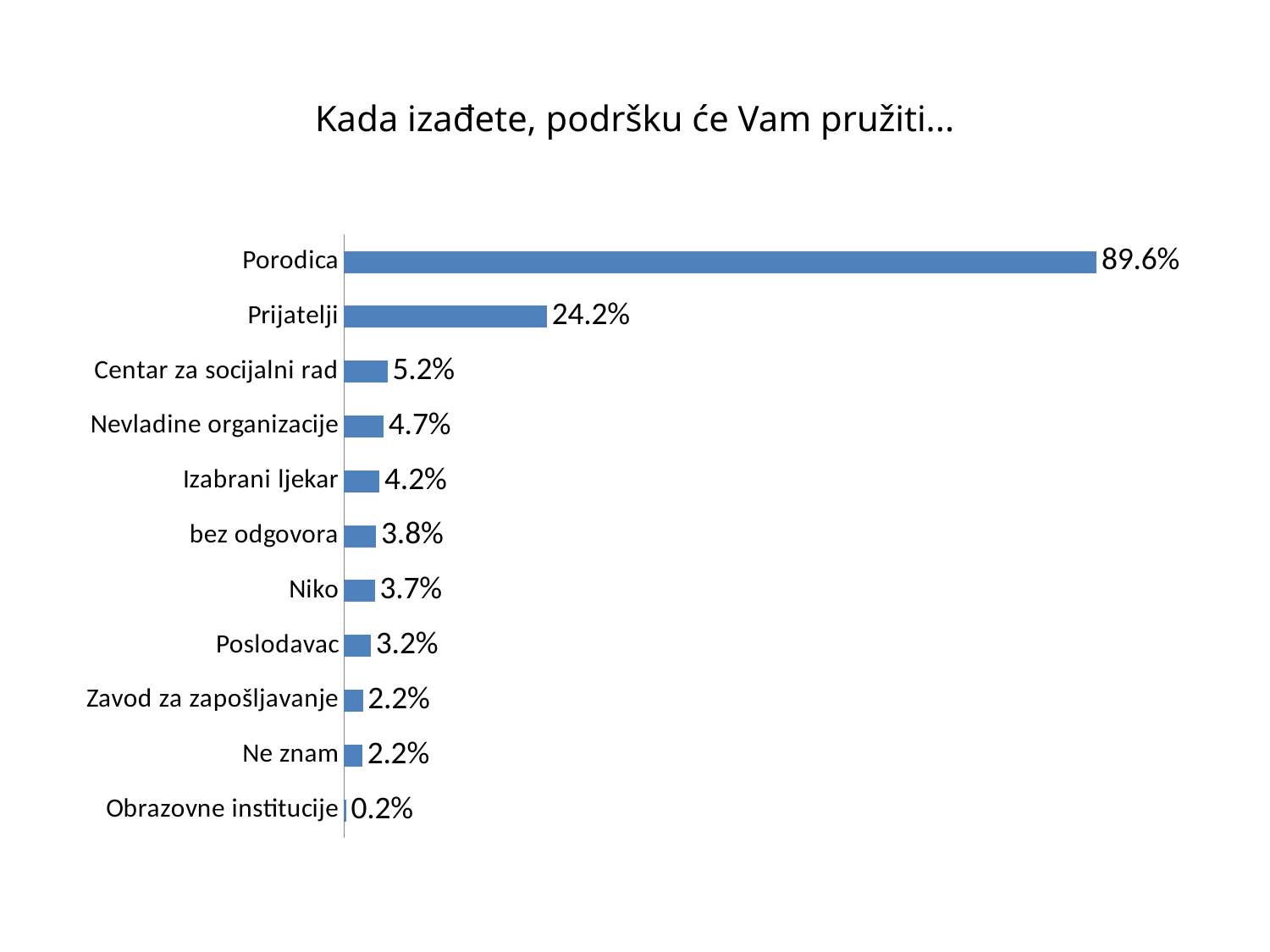
What is the difference between the values for Porodica and Prijatelji? 65.4% What is the title of the chart? Kada izađete, podršku će Vam pružiti... How many categories are shown in the chart? 11 What kind of chart is shown on the slide? Bar chart What is the value for Porodica? 89.6% Which category has the highest value? Porodica What is the value for Centar za socijalni rad? 5.2% What is the difference between the values for Centar za socijalni rad and Nevladine organizacije? 0.5% What is the value for Prijatelji? 24.2% Which is larger, the value for Izabrani ljekar or the value for Niko? Izabrani ljekar What is the value for Poslodavac? 3.2% Which category has the lowest value? Obrazovne institucije